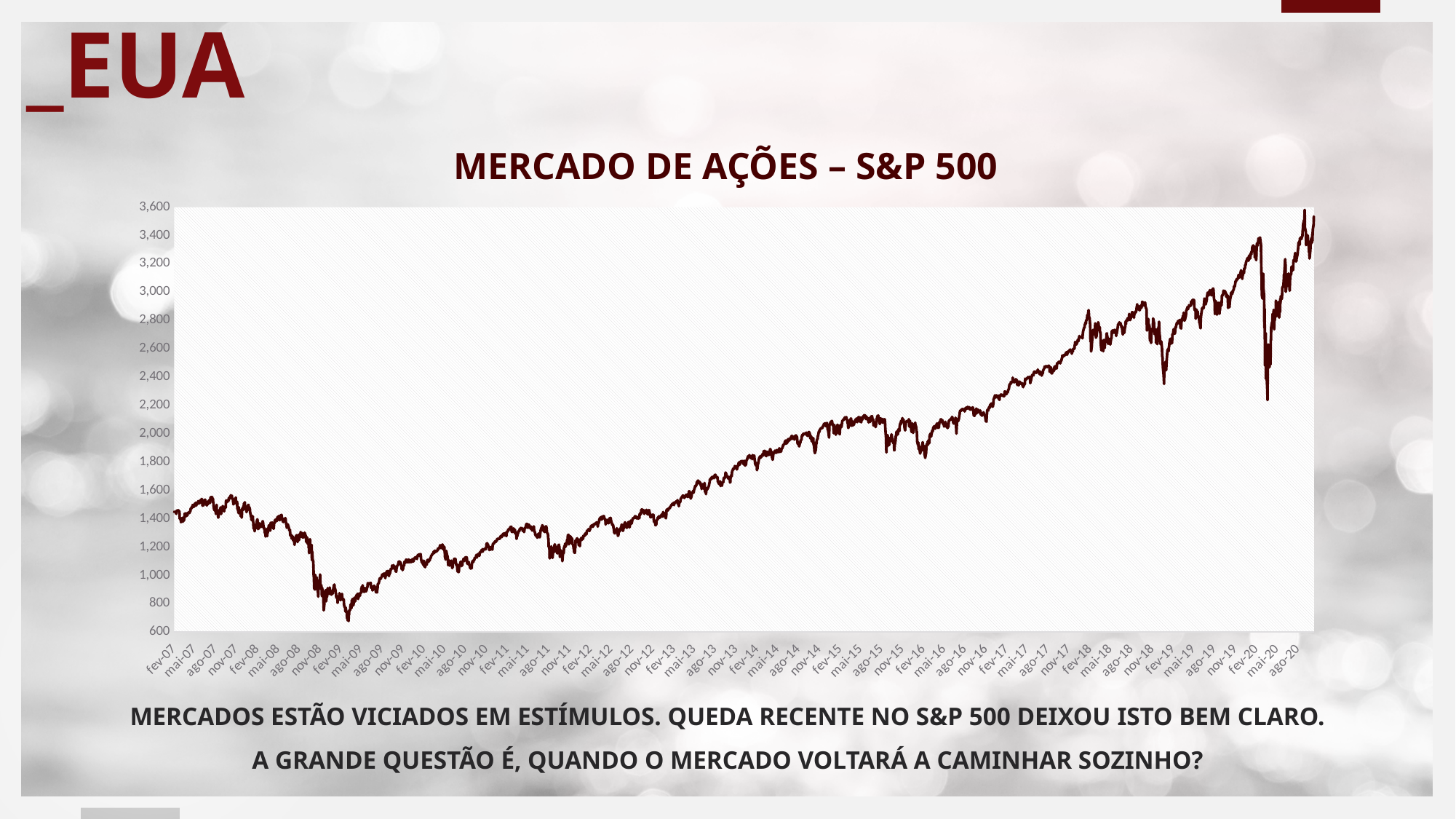
Is the value of the S&P 500 at ago-14 greater or less than 1,800? greater In which year does the S&P 500 line reach its lowest point? 2009 What is the highest value shown on the vertical axis? 3,600 Overall, does the S&P 500 line rise or fall from fev-07 to ago-20? rise Is the value of the S&P 500 at ago-20 greater or less than 3,000? greater Is the value of the S&P 500 at fev-07 greater or less than 1,200? greater What kind of chart is shown on the slide? line chart In which year does the S&P 500 line reach its highest point? 2020 What is the title of the chart? MERCADO DE AÇÕES – S&P 500